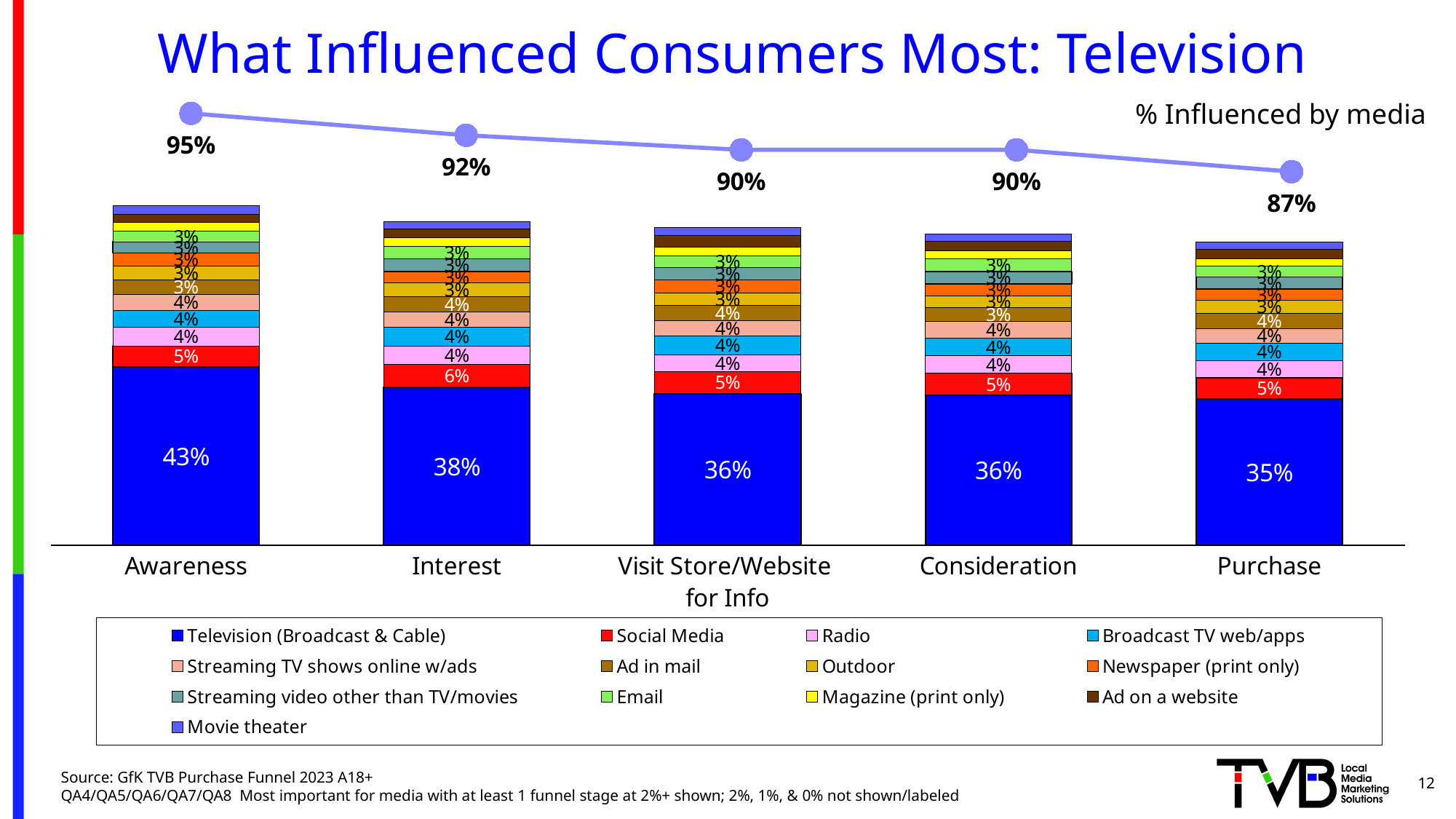
How many series does the legend list? 13 How many funnel stages (categories) are shown along the x axis? 5 At which stage is the Television (Broadcast & Cable) value lowest? Purchase What is the difference between the Television (Broadcast & Cable) value at Awareness and at Purchase? 8 percentage points What is the '% Influenced by media' value at the Purchase stage? 87% What is the title of the chart on the slide? What Influenced Consumers Most: Television What kind of chart is shown on the slide? Stacked bar chart with a line overlay Does the '% Influenced by media' line rise or fall from Awareness to Purchase? Fall What is the value for Television (Broadcast & Cable) at the Awareness stage? 43% Is the Social Media value larger at Interest or at Awareness? Interest At which stage is the Television (Broadcast & Cable) value highest? Awareness What is the '% Influenced by media' value at the Consideration stage? 90%